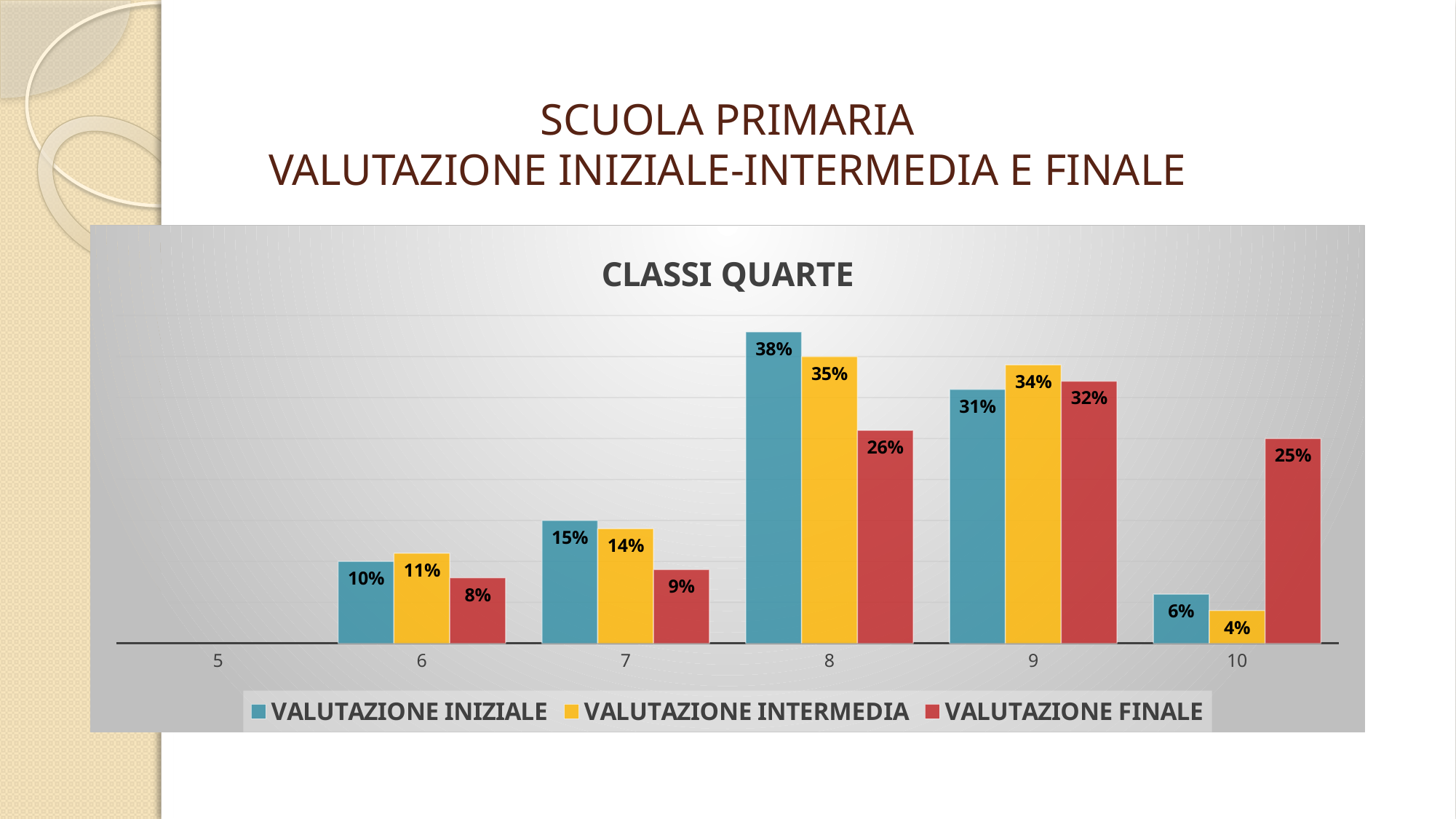
Which category has the highest VALUTAZIONE INIZIALE value? 8 How many categories are shown on the x axis? 6 How many series does the legend list? 3 Which category has the lowest VALUTAZIONE INTERMEDIA value? 10 What kind of chart is shown on the slide? Bar chart Which colour represents VALUTAZIONE FINALE in the legend? Red What is the VALUTAZIONE INTERMEDIA value for category 9? 34% What is the difference between the VALUTAZIONE INIZIALE and VALUTAZIONE FINALE values for category 8? 12% What is the VALUTAZIONE FINALE value for category 10? 25% What is the VALUTAZIONE INIZIALE value for category 8? 38% What is the title of the chart? CLASSI QUARTE For category 10, which is larger: VALUTAZIONE INIZIALE or VALUTAZIONE FINALE? VALUTAZIONE FINALE